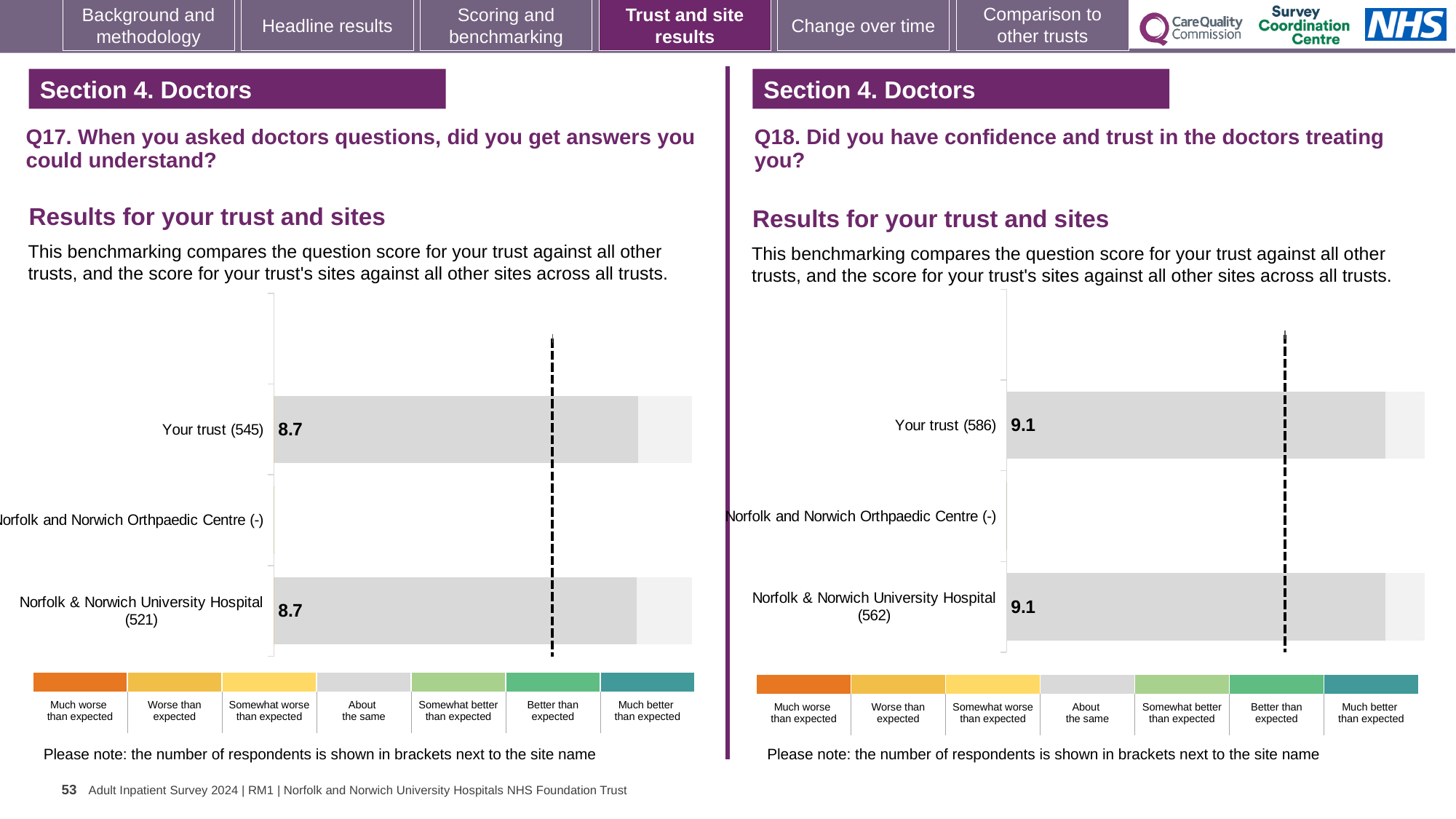
What is the difference between the Your trust score in the Q18 chart on the right and the Your trust score in the Q17 chart on the left? 0.4 How many categories are listed on the vertical axis of the Q17 chart on the left? 3 In the Q18 chart on the right, what is the score for Your trust? 9.1 How many categories are listed on the vertical axis of the Q18 chart on the right? 3 In the Q18 chart on the right, how many respondents are shown in brackets for Your trust? 586 What kind of chart is the Q17 chart on the left? Bar chart In the Q18 chart on the right, what is the score for Norfolk & Norwich University Hospital? 9.1 Is the score for Your trust larger in the Q17 chart on the left or in the Q18 chart on the right? Q18 chart on the right In the Q17 chart on the left, what is the score for Norfolk & Norwich University Hospital? 8.7 In the Q17 chart on the left, what is the score for Your trust? 8.7 In the Q17 chart on the left, which category has no bar plotted? Norfolk and Norwich Orthpaedic Centre (-)